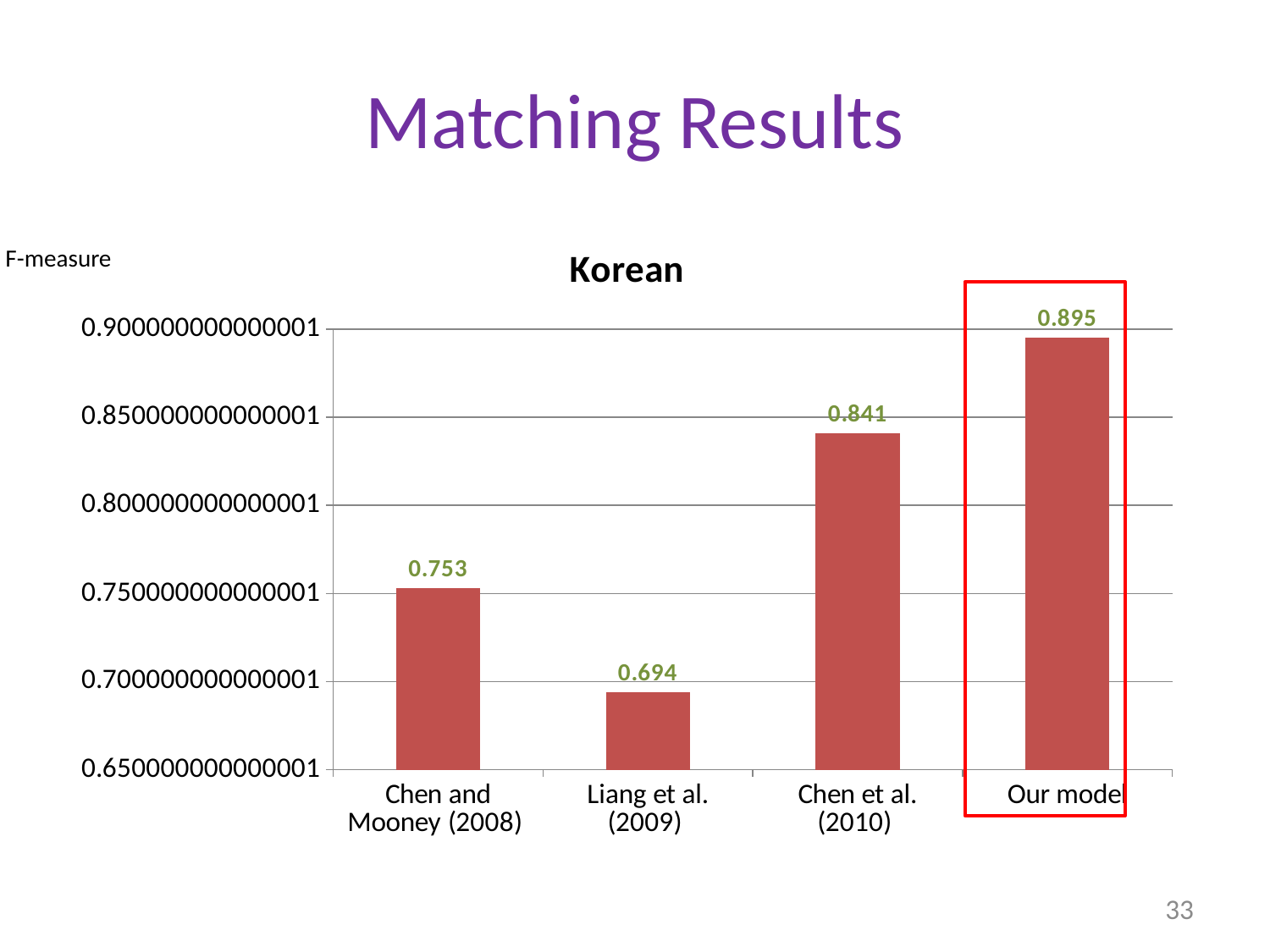
Which has a higher F-measure, Chen and Mooney (2008) or Chen et al. (2010)? Chen et al. (2010) What is the difference between the F-measure of Our model and Chen et al. (2010)? 0.054 Which category has the lowest F-measure? Liang et al. (2009) What is the F-measure for Chen et al. (2010)? 0.841 Which category is highlighted with a red box? Our model Which category has the highest F-measure? Our model What is the F-measure for Liang et al. (2009)? 0.694 What kind of chart is shown on the slide? Bar chart How many categories are shown in the chart? 4 What is the F-measure for Chen and Mooney (2008)? 0.753 What is the F-measure for Our model? 0.895 What is the title of the chart? Korean